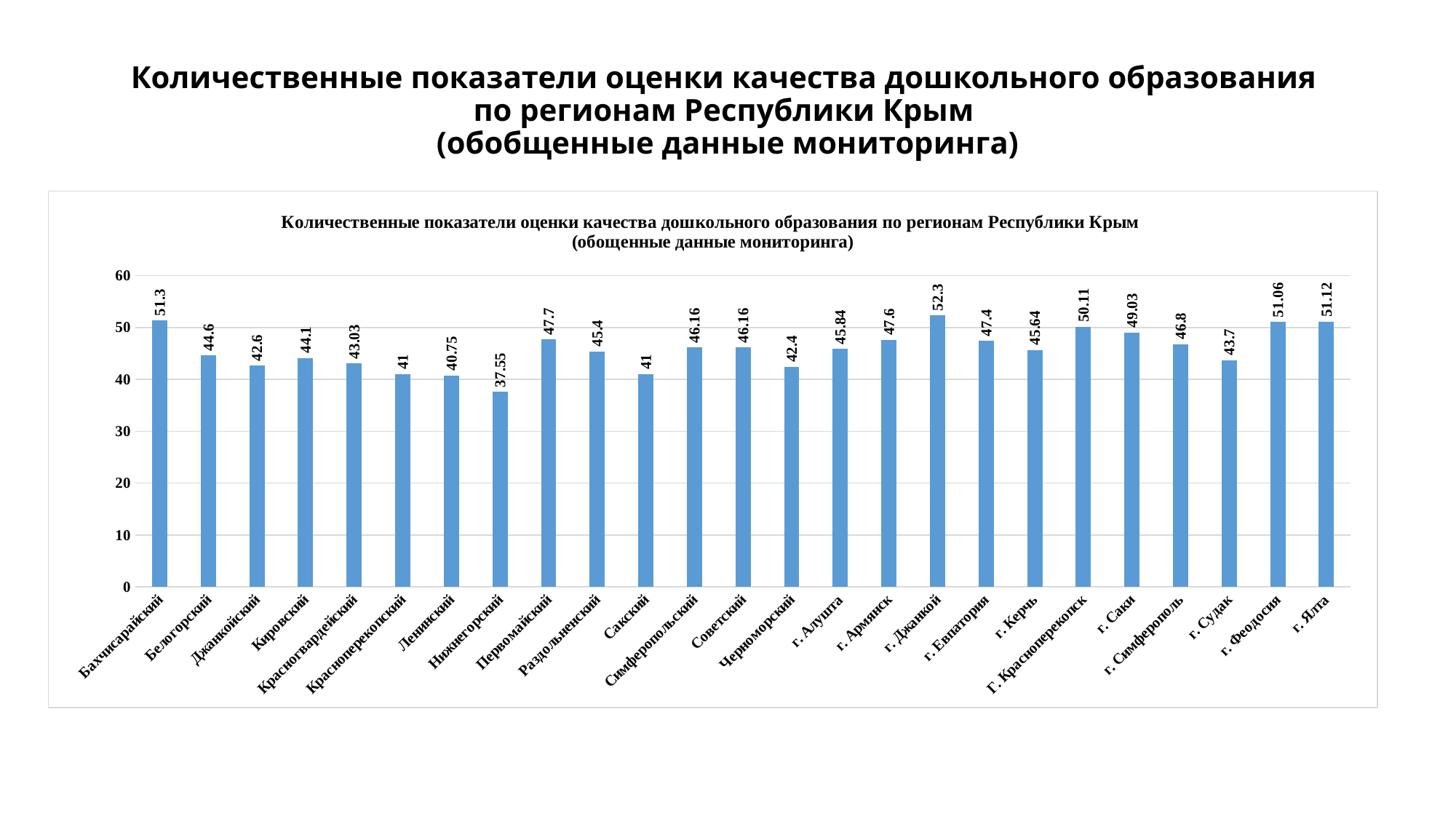
What is the value for Бахчисарайский? 51.3 What type of chart is shown on the slide? bar chart Which region has the highest value in the chart? г. Джанкой How many regions (categories) are plotted in the chart? 25 Which region has the lowest value in the chart? Нижнегорский What is the value for Нижнегорский? 37.55 What is the difference between the highest value (г. Джанкой) and the lowest value (Нижнегорский)? 14.75 What is the difference between the values for Бахчисарайский and Белогорский? 6.7 Which has a larger value, Первомайский or Раздольненский? Первомайский What is the value for г. Красноперекопск? 50.11 What is the value for г. Саки? 49.03 Is the value for Нижнегорский greater or less than 40? less